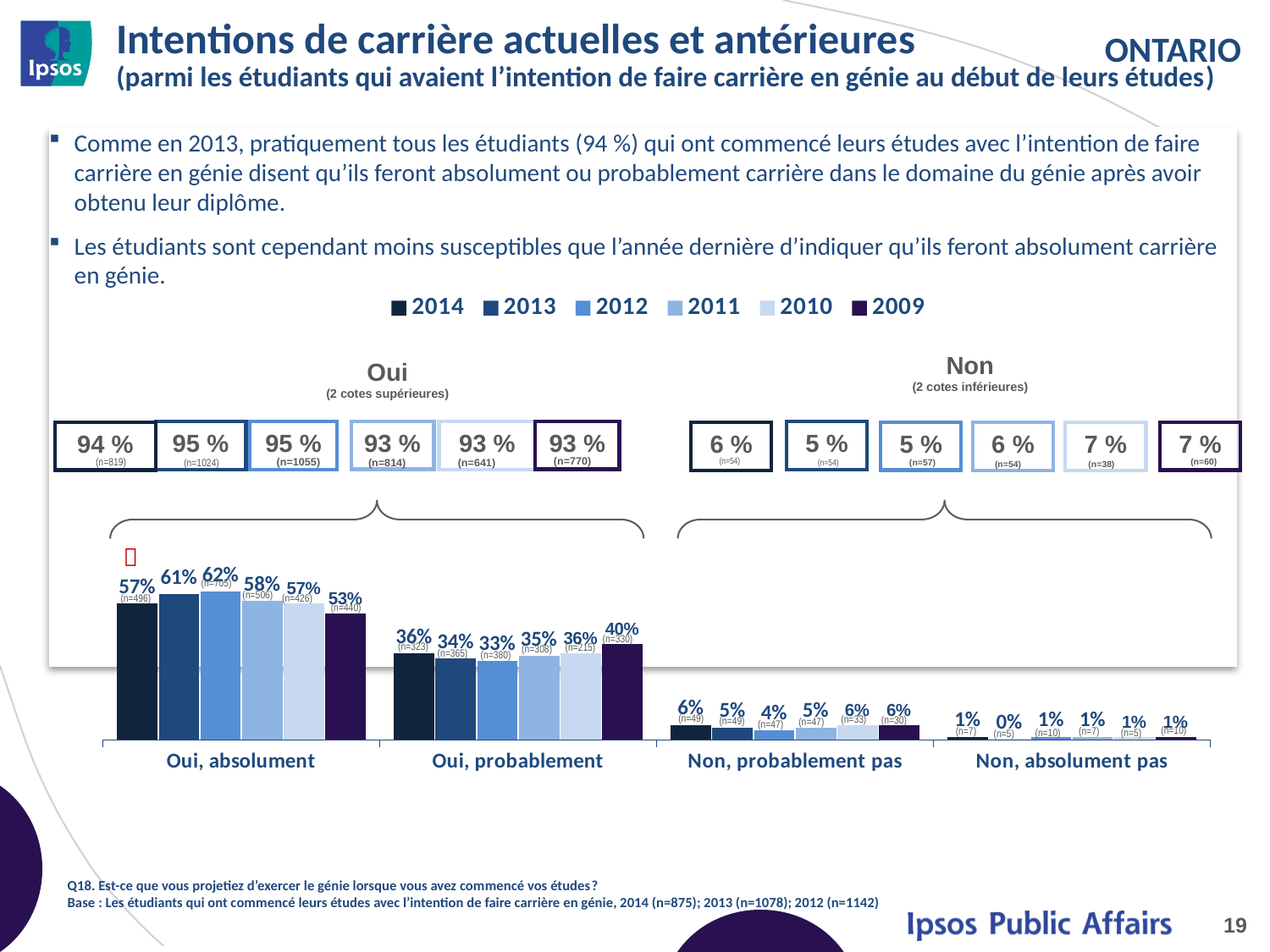
What is the value for 2012 in the "Non, probablement pas" category? 4% What kind of chart is shown on the slide? Bar chart How many categories are shown on the x axis of the chart? 4 Which is larger in the "Oui, probablement" category: the 2009 value or the 2012 value? 2009 What is the value for 2013 in the "Non, absolument pas" category? 0% Which year has the lowest value in the "Oui, absolument" category? 2009 Which year is shown in the darkest navy colour in the legend, listed first? 2014 Which year has the highest value in the "Oui, absolument" category? 2012 What is the value for 2014 in the "Oui, absolument" category? 57% What is the value for 2009 in the "Oui, probablement" category? 40% How many series does the legend list? 6 What is the difference between the 2012 and 2009 values in the "Oui, absolument" category? 9%